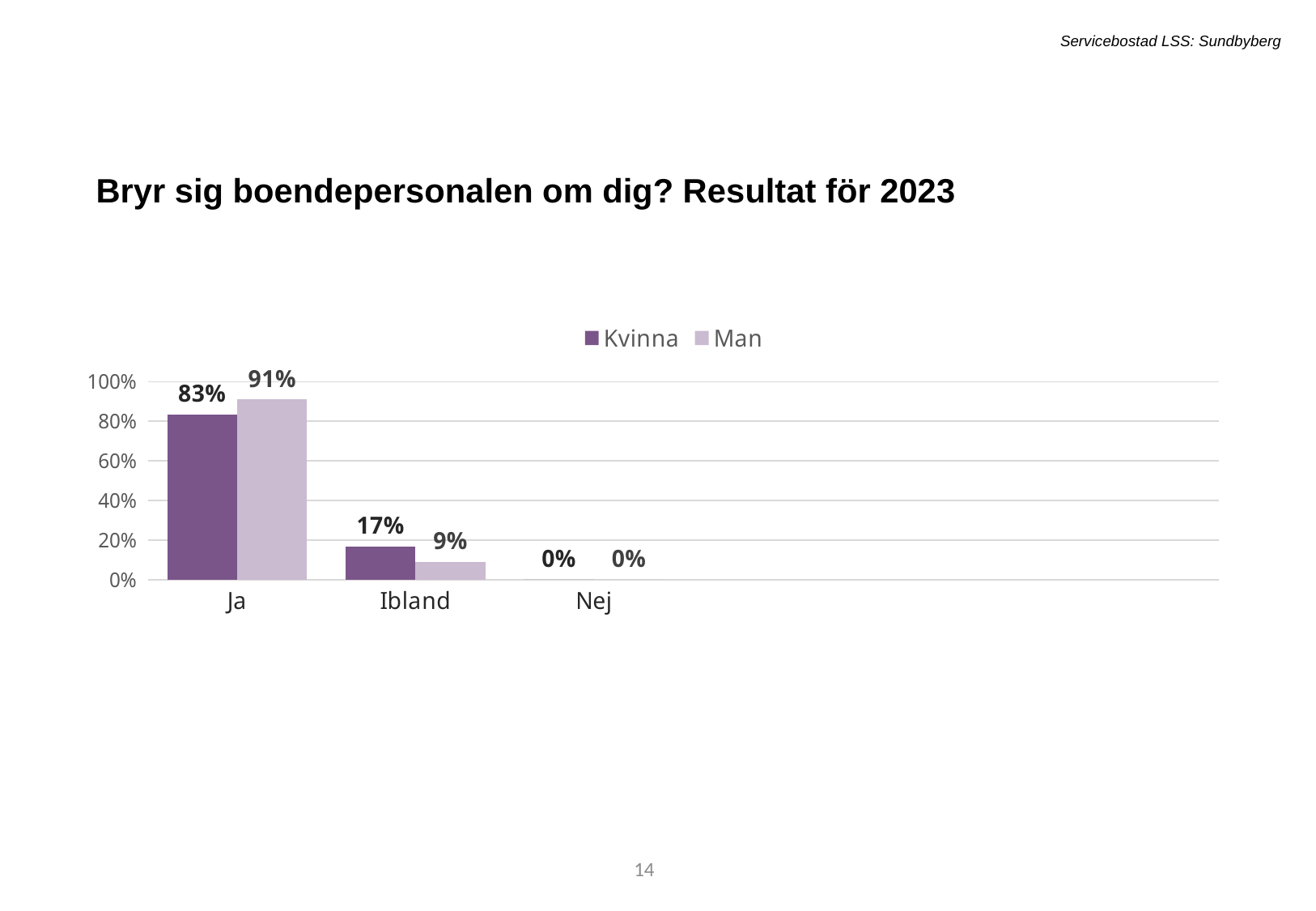
What kind of chart is shown on the slide? Bar chart What is the difference between the Man and Kvinna values in the Ja category? 8% How many series does the legend list? 2 What is the value for Kvinna in the Nej category? 0% What is the value for Man in the Ibland category? 9% What is the value for Kvinna in the Ibland category? 17% Which category has the lowest value for Kvinna? Nej Which category has the highest value for Man? Ja What is the value for Kvinna in the Ja category? 83% What is the value for Man in the Ja category? 91% How many categories are shown on the x axis? 3 In the Ibland category, which series has the larger value, Kvinna or Man? Kvinna